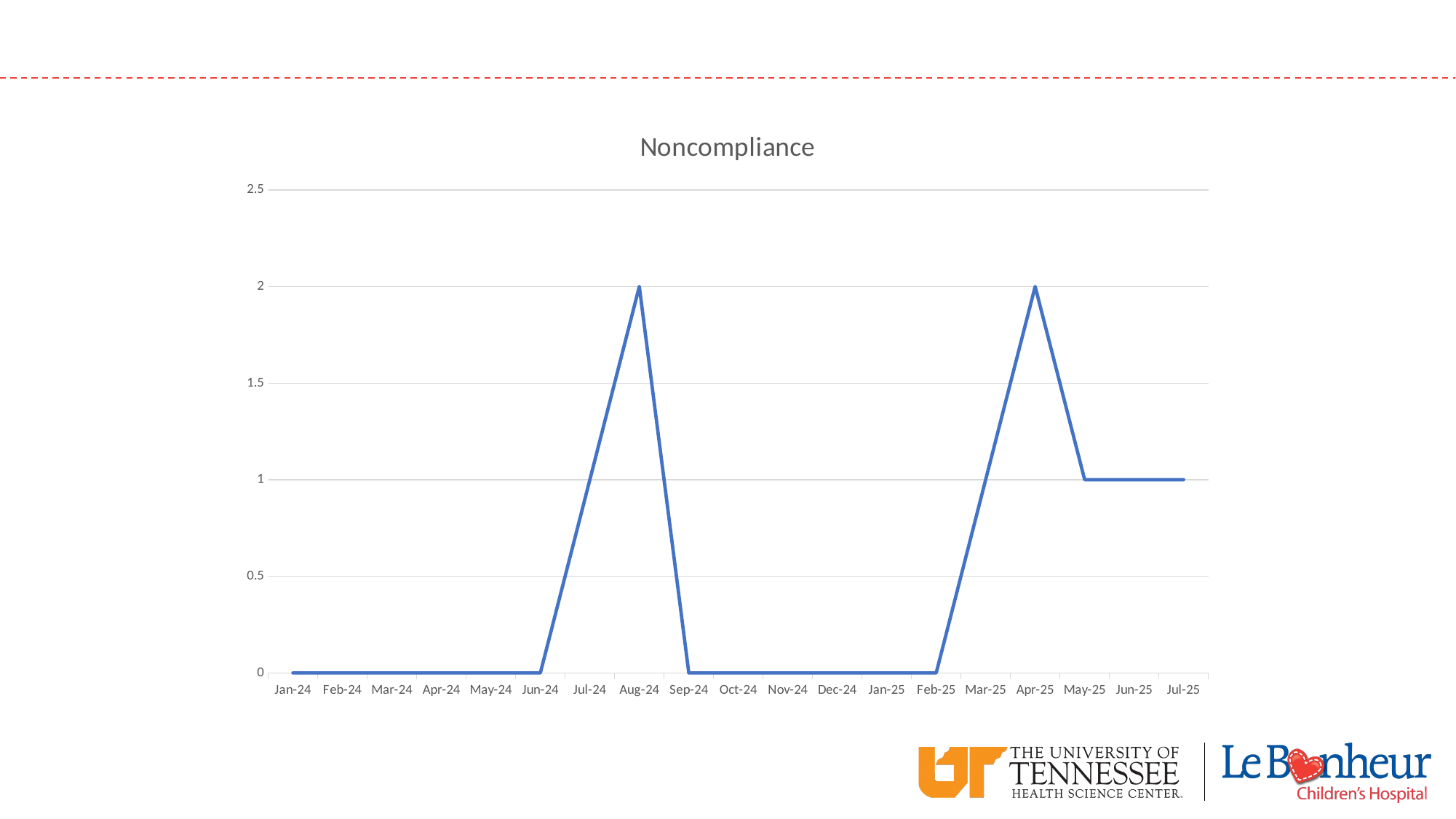
What is the title of the chart? Noncompliance What is the difference between the value for Apr-25 and the value for May-25? 1 What is the Noncompliance value for Dec-24? 0 Which is larger, the value for Aug-24 or the value for Sep-24? Aug-24 Is the value for Apr-25 greater or less than 1.5? greater What is the Noncompliance value for Aug-24? 2 What is the highest value reached on the chart? 2 What kind of chart is shown on the slide? line chart What is the Noncompliance value for Jul-25? 1 How many months are plotted on the x axis? 19 What is the Noncompliance value for Jan-24? 0 What is the Noncompliance value for Apr-25? 2